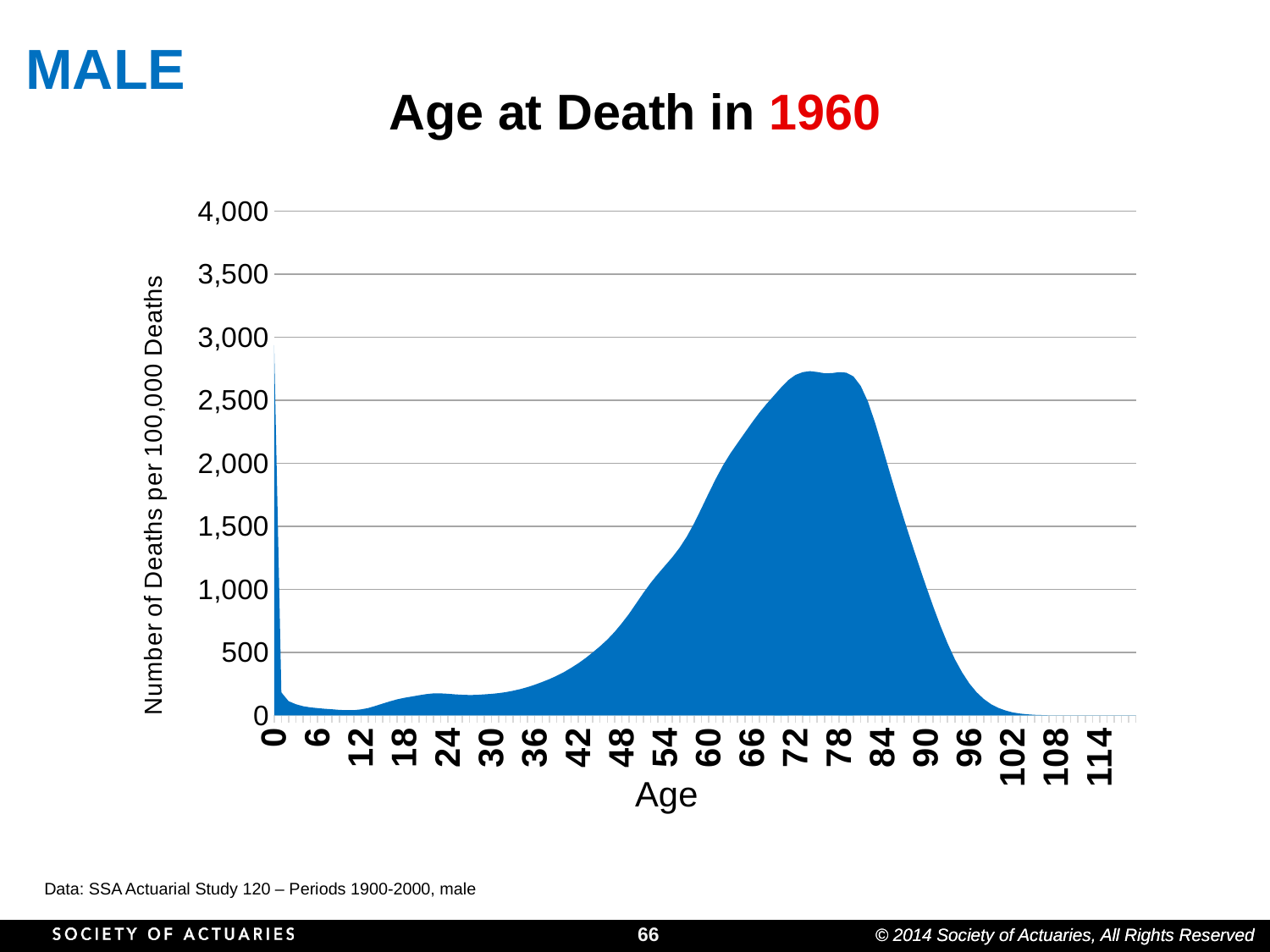
Is the value for age 72 greater or less than 2,500? greater What is the label of the vertical axis? Number of Deaths per 100,000 Deaths Is the value for age 102 greater or less than 500? less Do the values rise or fall as age increases from 78 to 102? Fall Which is larger, the value at age 72 or the value at age 48? Age 72 Is the value for age 0 greater or less than 2,500? greater Do the values rise or fall as age increases from 36 to 72? Rise What is the title of the chart? Age at Death in 1960 What kind of chart is shown on the slide? Area chart